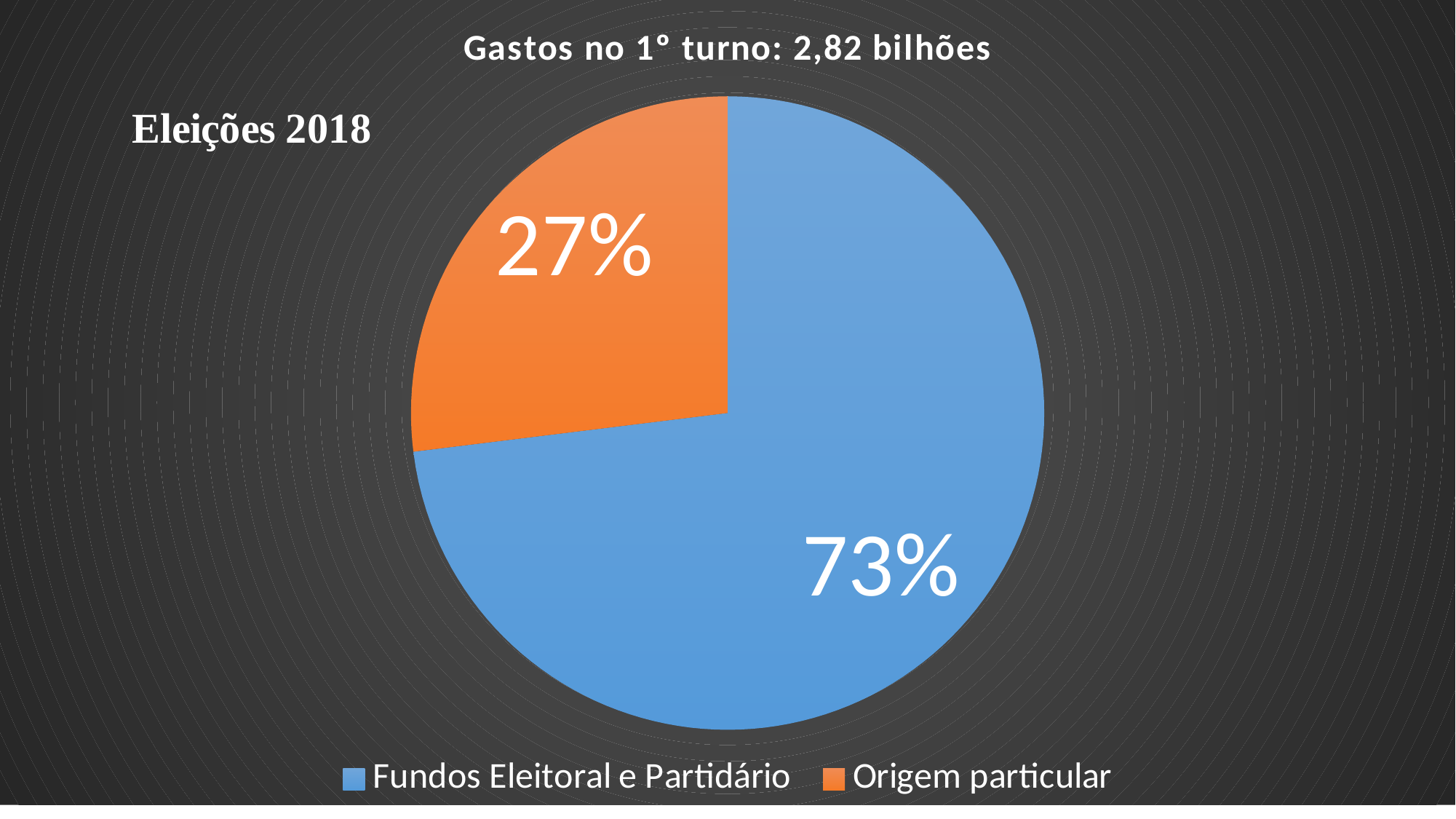
What is the difference in percentage points between Fundos Eleitoral e Partidário and Origem particular? 46 What colour is the Origem particular slice? orange What share of the pie does Fundos Eleitoral e Partidário represent? 73% How many entries does the legend list? 2 What share of the pie does Origem particular represent? 27% How many slices does the pie chart have? 2 What is the title of the chart? Gastos no 1° turno: 2,82 bilhões Which is larger, Fundos Eleitoral e Partidário or Origem particular? Fundos Eleitoral e Partidário Which slice is the smallest? Origem particular What kind of chart is shown on the slide? pie chart Which slice is the largest? Fundos Eleitoral e Partidário